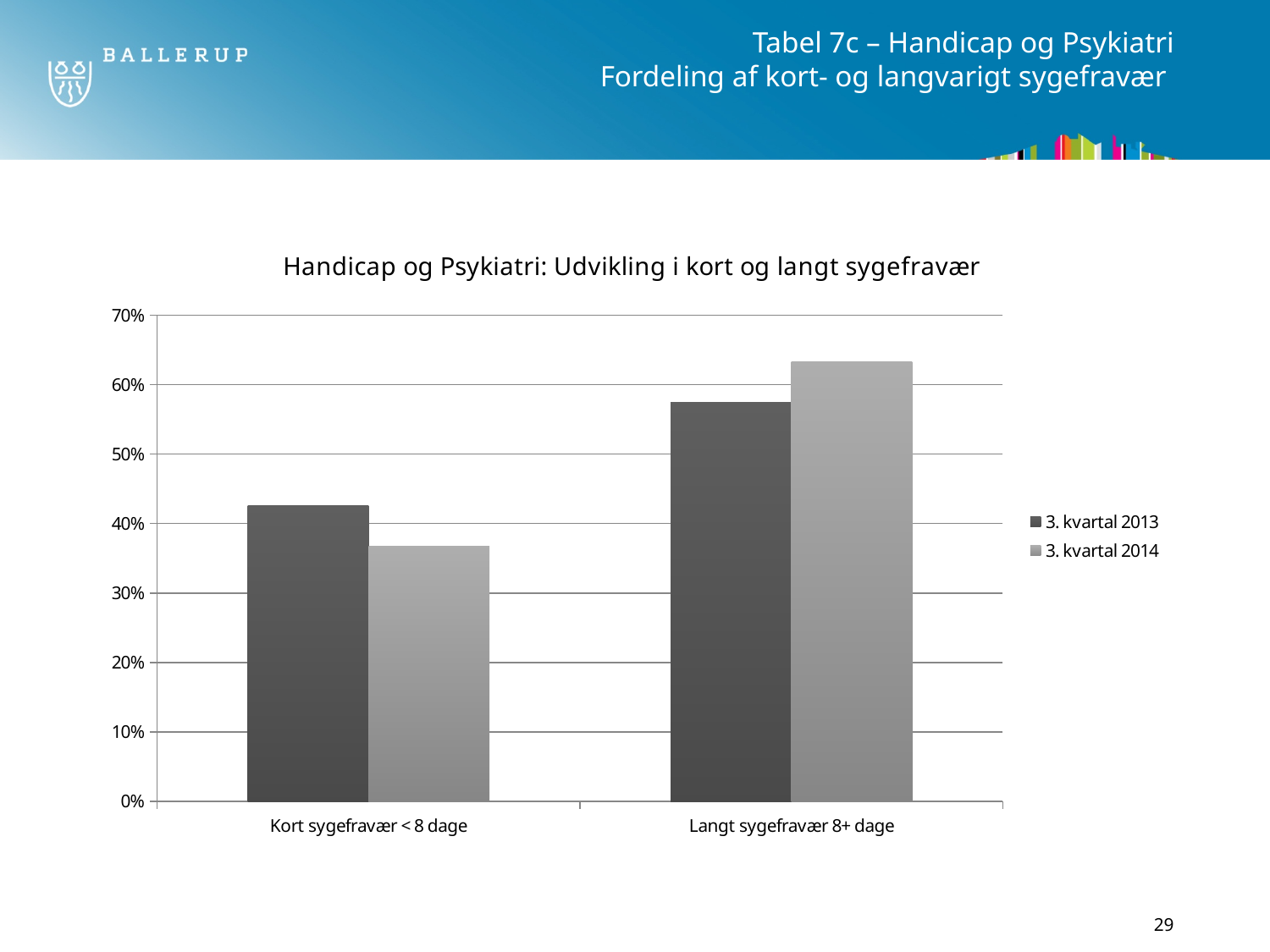
Which is larger for Langt sygefravær 8+ dage: 3. kvartal 2013 or 3. kvartal 2014? 3. kvartal 2014 What is the title of the chart? Handicap og Psykiatri: Udvikling i kort og langt sygefravær Is the value for Langt sygefravær 8+ dage in 3. kvartal 2013 greater or less than 60%? less How many categories are shown on the x axis? 2 Which category has the highest value in 3. kvartal 2014? Langt sygefravær 8+ dage Which is larger for Kort sygefravær < 8 dage: 3. kvartal 2013 or 3. kvartal 2014? 3. kvartal 2013 Is the value for Langt sygefravær 8+ dage in 3. kvartal 2014 greater or less than 60%? greater Which category has the lowest value in 3. kvartal 2013? Kort sygefravær < 8 dage What kind of chart is shown on the slide? bar chart How many series does the legend list? 2 Is the value for Kort sygefravær < 8 dage in 3. kvartal 2013 greater or less than 40%? greater